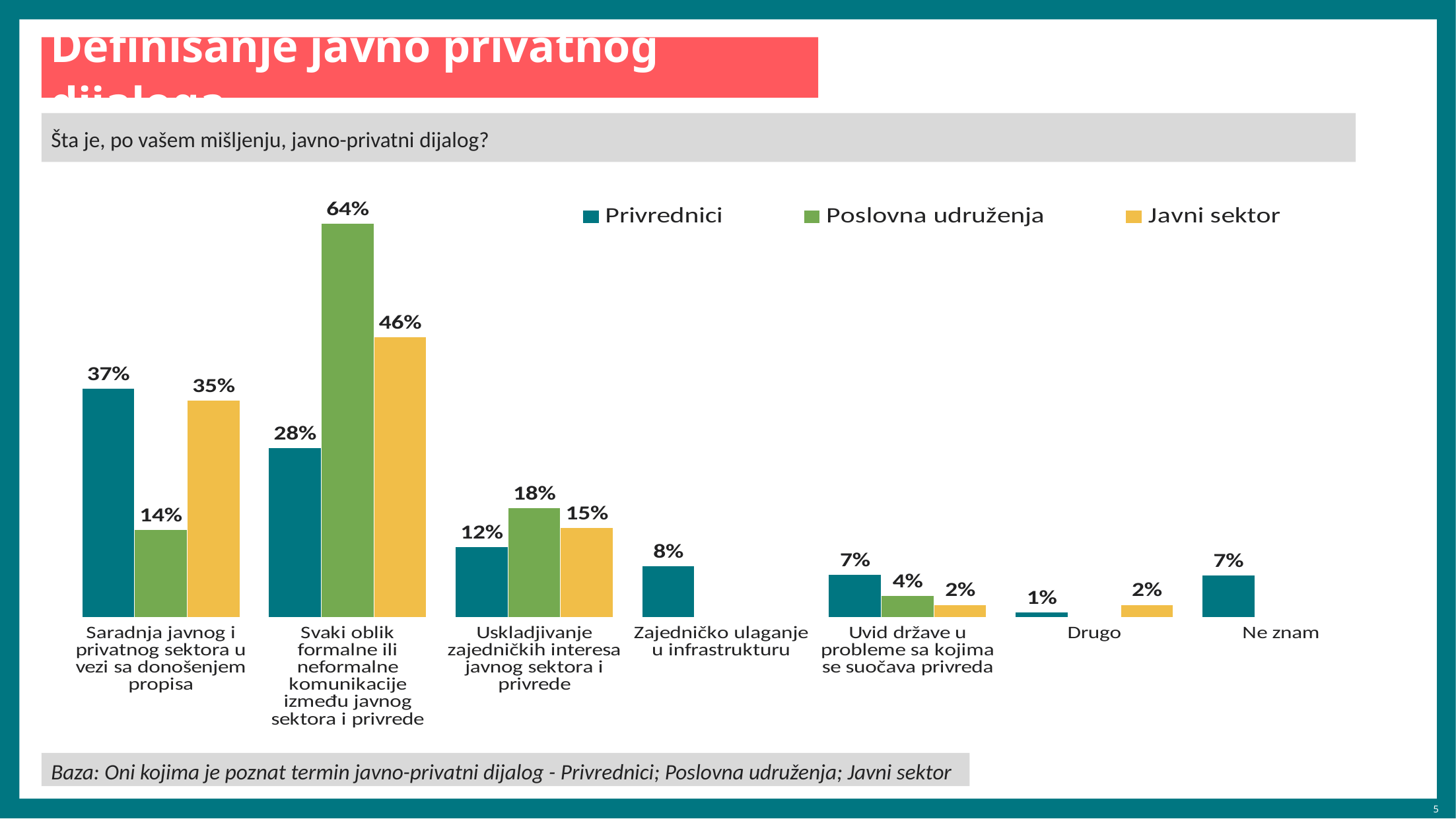
What is the difference between the Poslovna udruženja and Privrednici values in the category 'Svaki oblik formalne ili neformalne komunikacije između javnog sektora i privrede'? 36% Which series is shown in yellow in the legend? Javni sektor How many categories are shown on the x axis? 7 In the category 'Uskladjivanje zajedničkih interesa javnog sektora i privrede', which series has the larger value: Privrednici or Javni sektor? Javni sektor What is the value for Privrednici in the category 'Zajedničko ulaganje u infrastrukturu'? 8% Which category has the highest value for Privrednici? Saradnja javnog i privatnog sektora u vezi sa donošenjem propisa What is the value for Javni sektor in the category 'Drugo'? 2% Which category has the lowest value for Privrednici? Drugo What is the value for Poslovna udruženja in the category 'Svaki oblik formalne ili neformalne komunikacije između javnog sektora i privrede'? 64% How many series does the legend list? 3 What is the value for Javni sektor in the category 'Saradnja javnog i privatnog sektora u vezi sa donošenjem propisa'? 35% What kind of chart is shown on the slide? bar chart